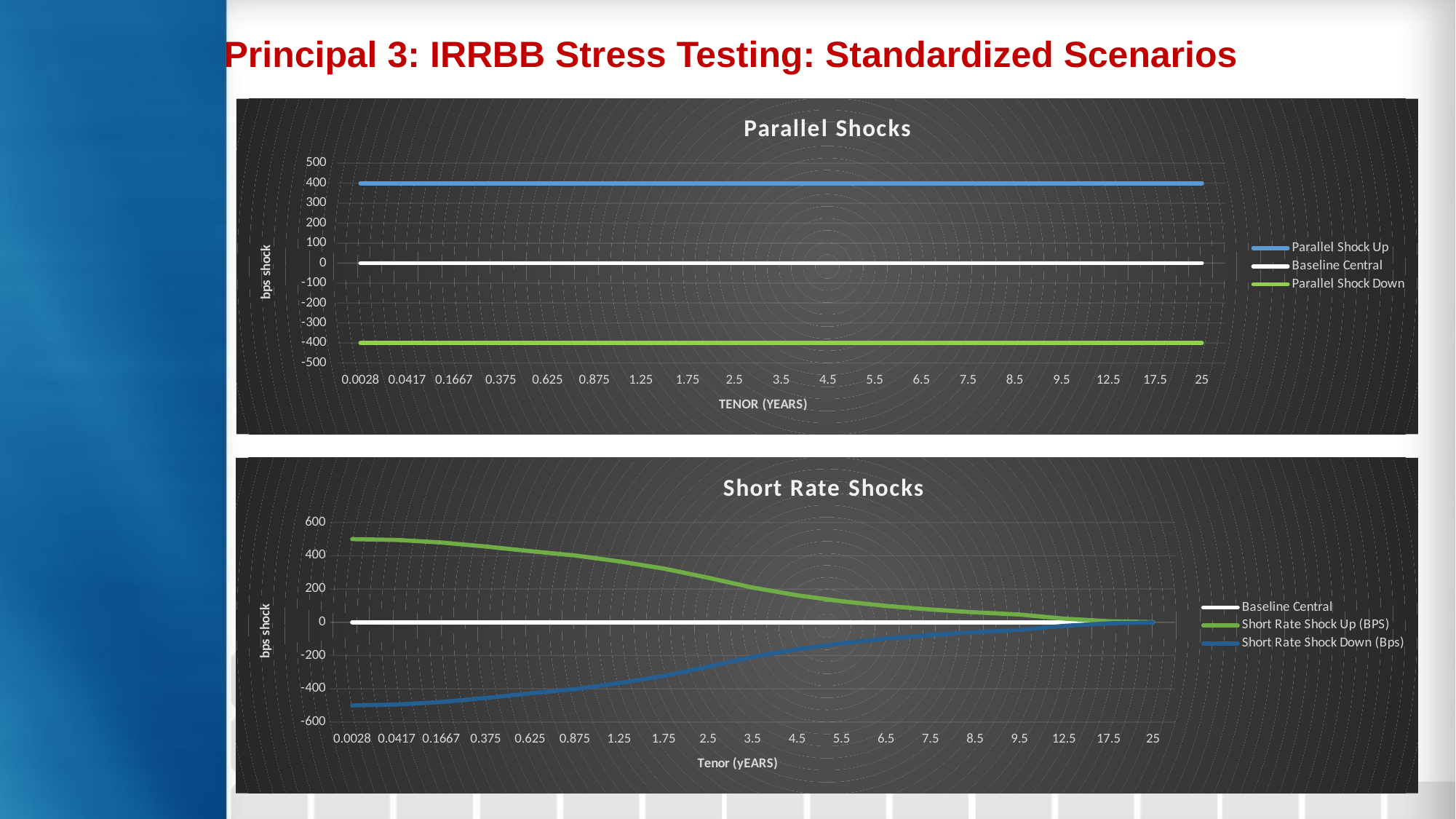
How many tenor points are shown on the x axis of the "Short Rate Shocks" chart? 19 How many series does the legend of the "Short Rate Shocks" chart list? 3 In the "Parallel Shocks" chart, what is the value of the Parallel Shock Up series at tenor 25? 400 How many series does the legend of the "Parallel Shocks" chart list? 3 In the "Parallel Shocks" chart, what is the difference between the Parallel Shock Up and Parallel Shock Down values at tenor 1.25? 800 In the "Parallel Shocks" chart, what is the value of the Parallel Shock Down series at tenor 0.0028? -400 In the "Short Rate Shocks" chart, is the value of Short Rate Shock Up (BPS) at tenor 0.0028 greater or less than 400? greater In the "Parallel Shocks" chart, what is the value of the Baseline Central series at tenor 3.5? 0 In the "Short Rate Shocks" chart, does the Short Rate Shock Up (BPS) series rise or fall as tenor increases? fall In the "Short Rate Shocks" chart, is the value of Short Rate Shock Down (Bps) at tenor 0.0028 greater or less than -400? less In the "Parallel Shocks" chart, which series has the highest values? Parallel Shock Up What kind of chart is the "Parallel Shocks" chart? line chart